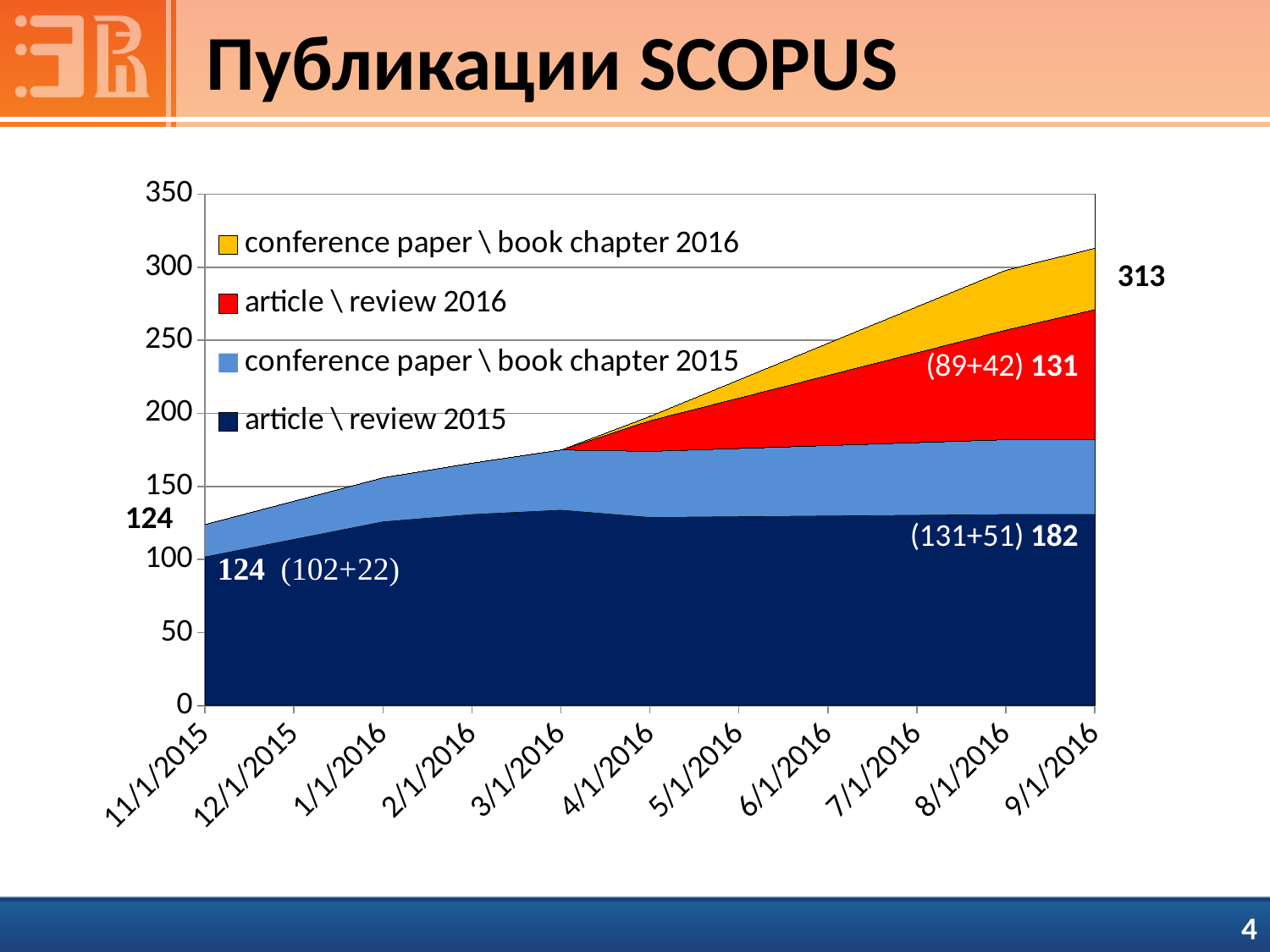
What is the total number of publications labelled at 11/1/2015? 124 Which series is shown in yellow in the legend? conference paper \ book chapter 2016 What kind of chart is shown on the slide? area chart How many series does the legend list? 4 By how much did the total number of publications increase from 11/1/2015 (124) to 9/1/2016 (313)? 189 Does the total number of publications rise or fall from 11/1/2015 to 9/1/2016? rise How many dates are shown on the x axis? 11 What is the labelled total for the 2016 publications (article \ review 2016 plus conference paper \ book chapter 2016) at 9/1/2016? 131 What is the total number of publications labelled at 9/1/2016? 313 According to the label at 11/1/2015, how many article \ review 2015 publications were there? 102 What is the labelled total for the 2015 publications (article \ review 2015 plus conference paper \ book chapter 2015) at 9/1/2016? 182 Is the total stacked value at 3/1/2016 greater or less than 200? less